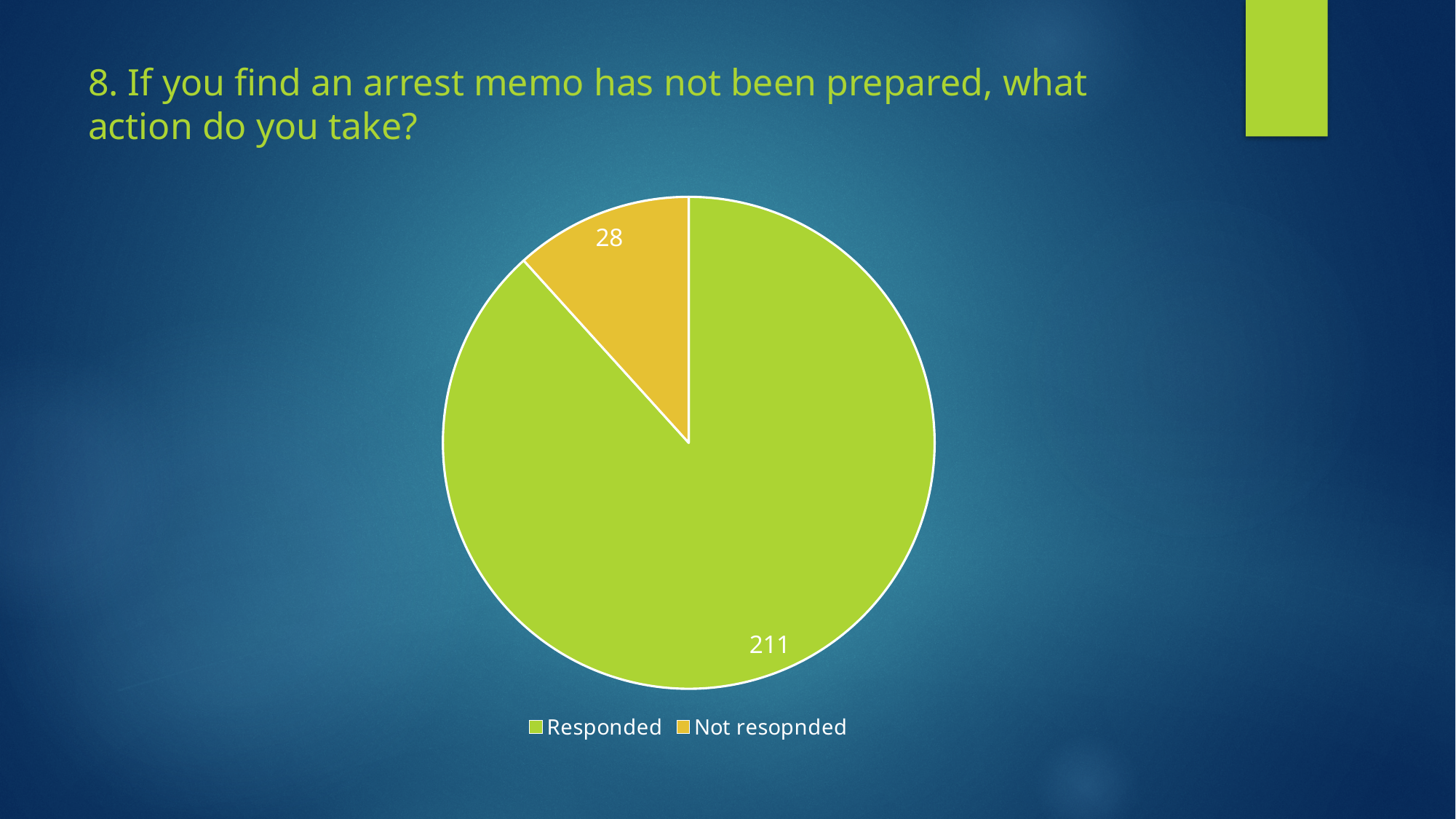
How many slices does the pie chart have? 2 Which slice of the pie is the smallest? Not resopnded What is the value for the Not resopnded slice? 28 Which is larger, the Responded value or the Not resopnded value? Responded How many entries does the legend list? 2 What is the difference between the Responded and Not resopnded values? 183 What colour is the Responded slice? Green Which slice of the pie is the largest? Responded What is the value for the Responded slice? 211 What is the total of all slices in the pie chart? 239 What share of the pie does the Not resopnded slice represent, to the nearest whole percent? 12% What type of chart is shown on the slide? Pie chart